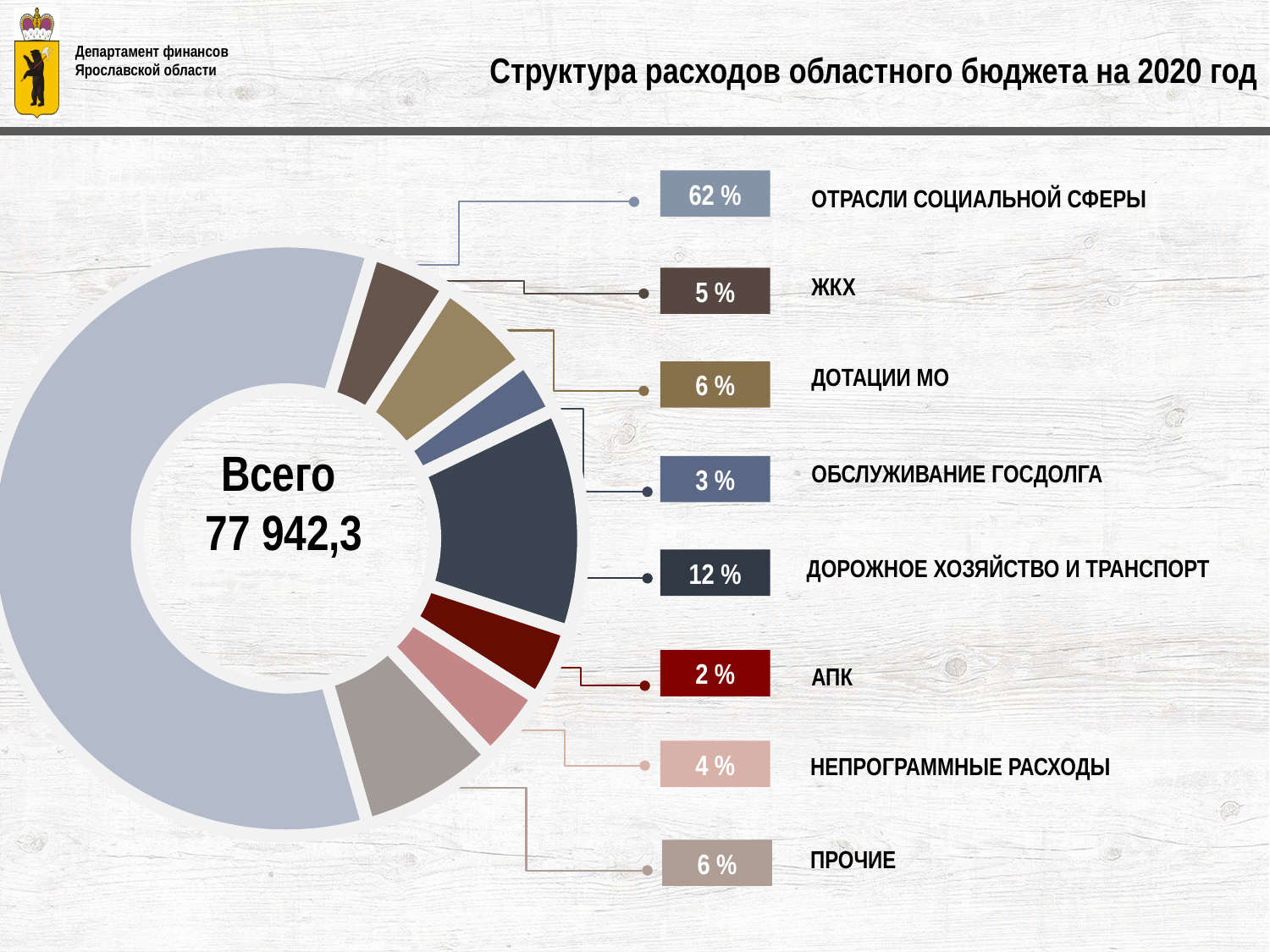
What total value is shown in the centre of the chart? 77 942,3 How many expenditure categories are shown in the chart? 8 What is the difference in percentage points between ОТРАСЛИ СОЦИАЛЬНОЙ СФЕРЫ and ДОРОЖНОЕ ХОЗЯЙСТВО И ТРАНСПОРТ? 50 percentage points What is the title of the slide? Структура расходов областного бюджета на 2020 год Which category has the largest share of the budget expenditure? ОТРАСЛИ СОЦИАЛЬНОЙ СФЕРЫ Which category has the smallest share of the budget expenditure? АПК What percentage is shown for ОБСЛУЖИВАНИЕ ГОСДОЛГА? 3 % What percentage is shown for АПК? 2 % Which has a larger share: ЖКХ or НЕПРОГРАММНЫЕ РАСХОДЫ? ЖКХ What kind of chart is shown on the slide? Donut (pie) chart What percentage is shown for ДОРОЖНОЕ ХОЗЯЙСТВО И ТРАНСПОРТ? 12 % What share of the budget expenditure goes to ОТРАСЛИ СОЦИАЛЬНОЙ СФЕРЫ? 62 %